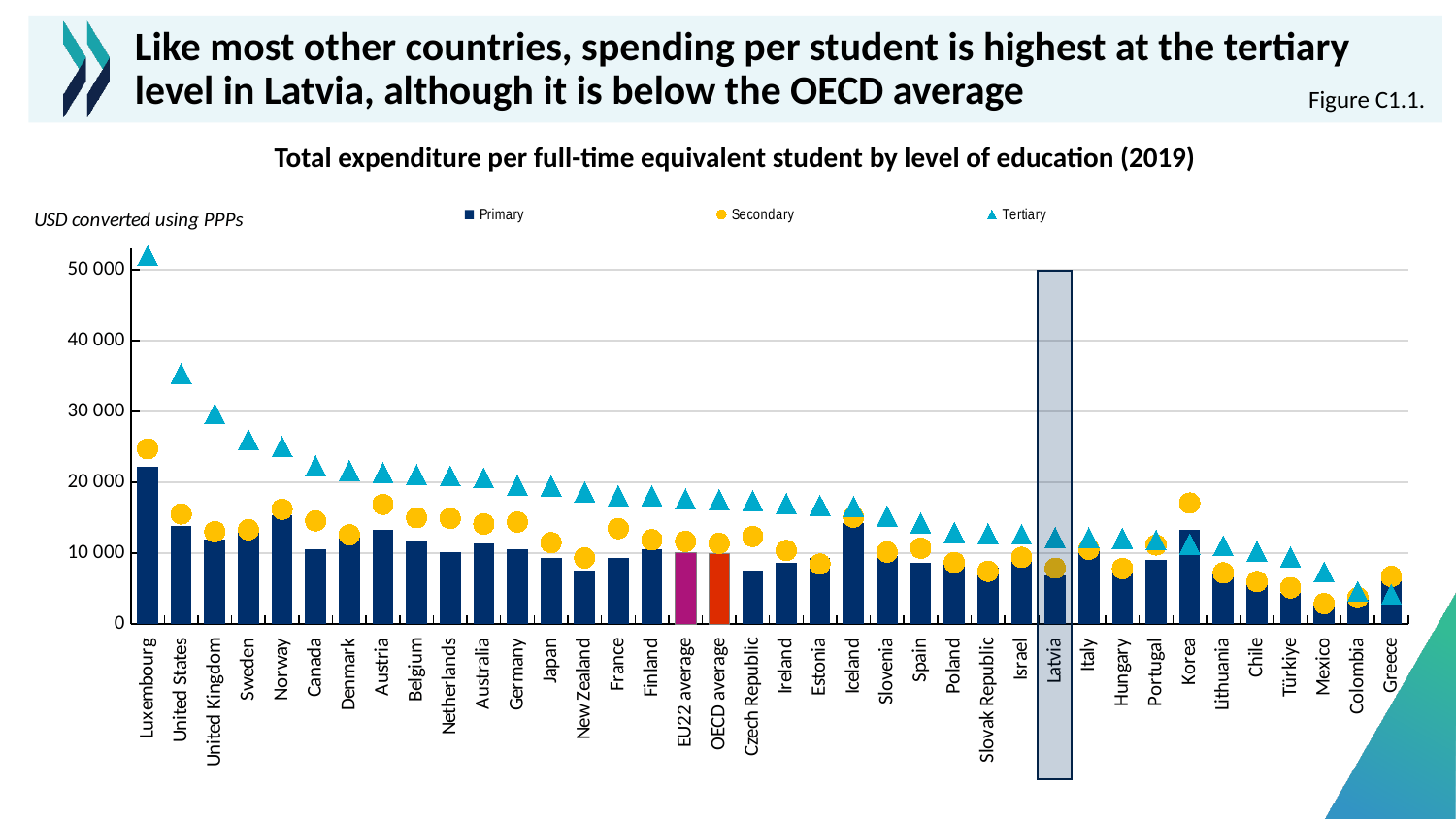
How many series does the chart's legend list? 3 Is the Tertiary value for Latvia greater or less than 20 000? less What is the title of the chart? Total expenditure per full-time equivalent student by level of education (2019) Which country has the highest Tertiary value in the chart? Luxembourg Is the Tertiary value for the United States greater or less than 30 000? greater Which country has the highest Primary value in the chart? Luxembourg Which series is shown with triangle markers in the chart? Tertiary Do the Tertiary values generally rise or fall from left to right along the x axis? fall How many countries or averages are shown along the x axis of the chart? 38 Is the Secondary value for Korea greater or less than 10 000? greater Which has the larger Tertiary value, Luxembourg or the United States? Luxembourg